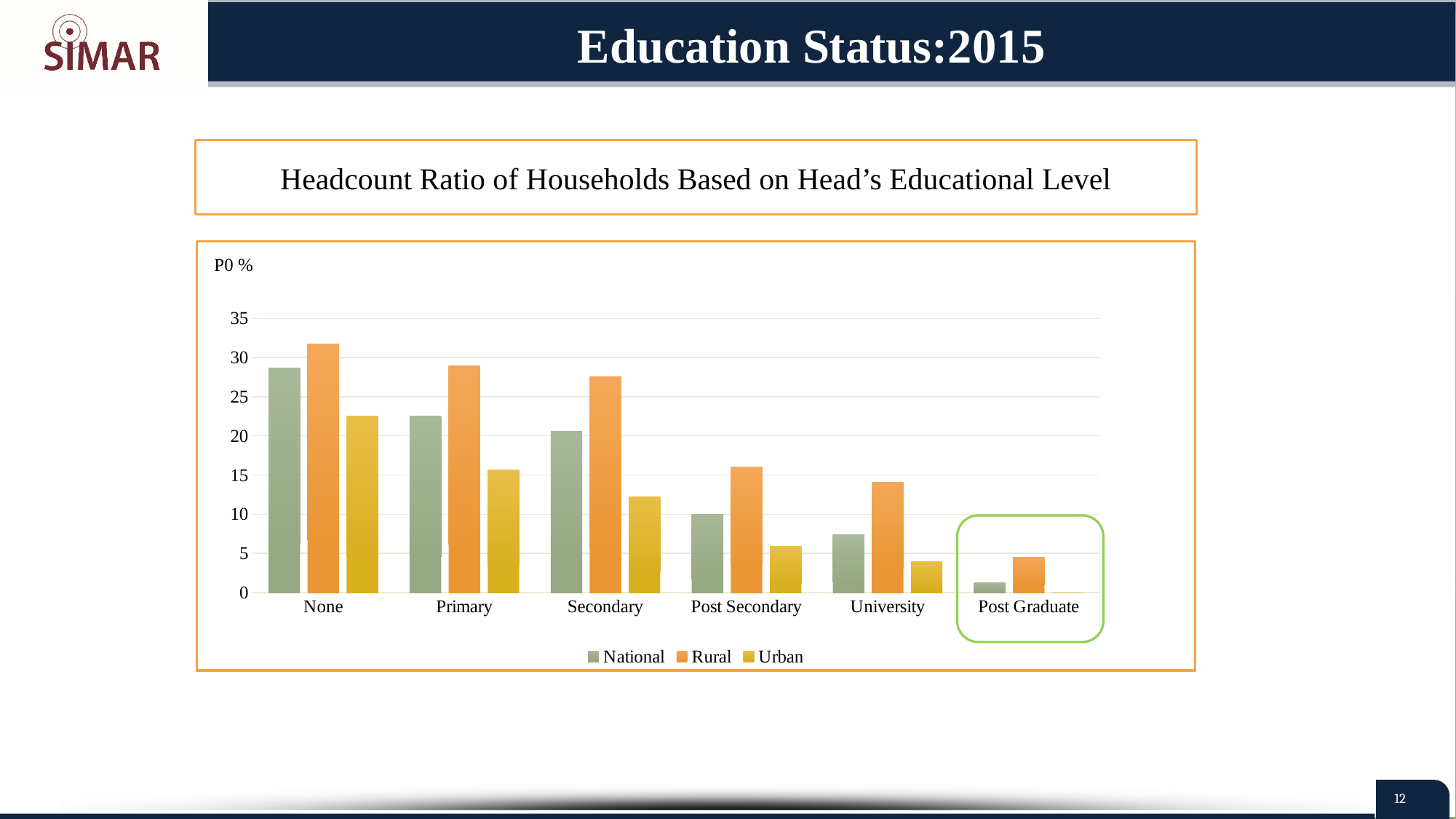
Do the National values rise or fall as the educational level moves from None to Post Graduate? fall Which educational level has the highest Rural value? None Is the Rural value for None greater or less than 30? greater Is the National value for Primary greater or less than 20? greater How many series does the legend list? 3 Is the National value for Post Graduate greater or less than 5? less What are the three series listed in the legend? National, Rural, Urban How many educational level categories are shown on the x axis? 6 For Post Secondary, which is larger, the Rural value or the Urban value? Rural Which educational level has the lowest Urban value? Post Graduate What kind of chart is shown on the slide? bar chart